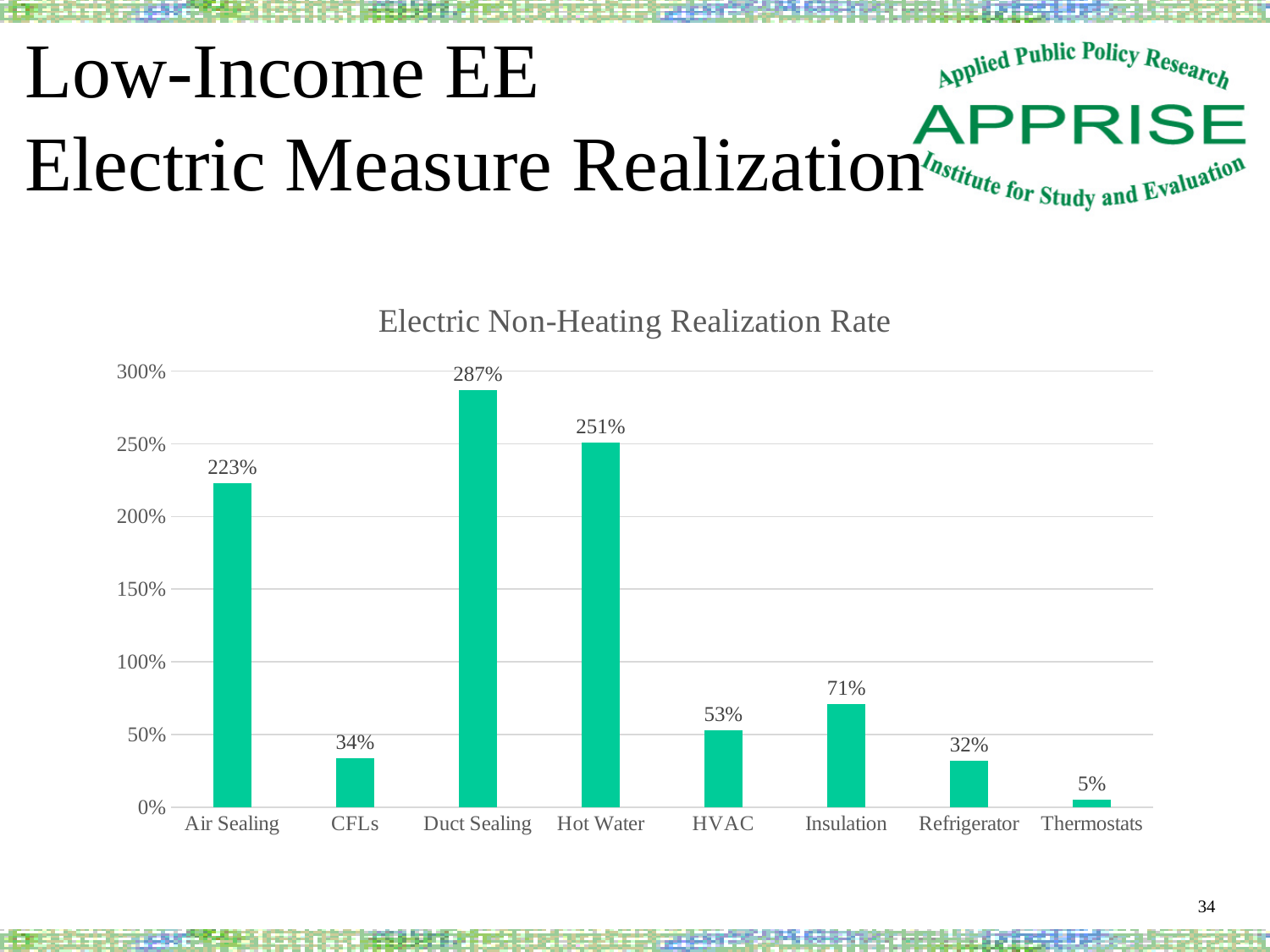
What is the difference between the realization rates for HVAC and CFLs? 19% Which has a higher realization rate, Air Sealing or Hot Water? Hot Water What is the realization rate for Insulation? 71% What is the realization rate for Refrigerator? 32% Is the value for Insulation greater or less than 100%? less What kind of chart is shown on the slide? bar chart What is the difference between the realization rates for Duct Sealing and Hot Water? 36% What is the realization rate for Duct Sealing? 287% How many measures are shown on the x axis? 8 What is the title of the chart? Electric Non-Heating Realization Rate Which measure has the lowest realization rate? Thermostats Which measure has the highest realization rate? Duct Sealing